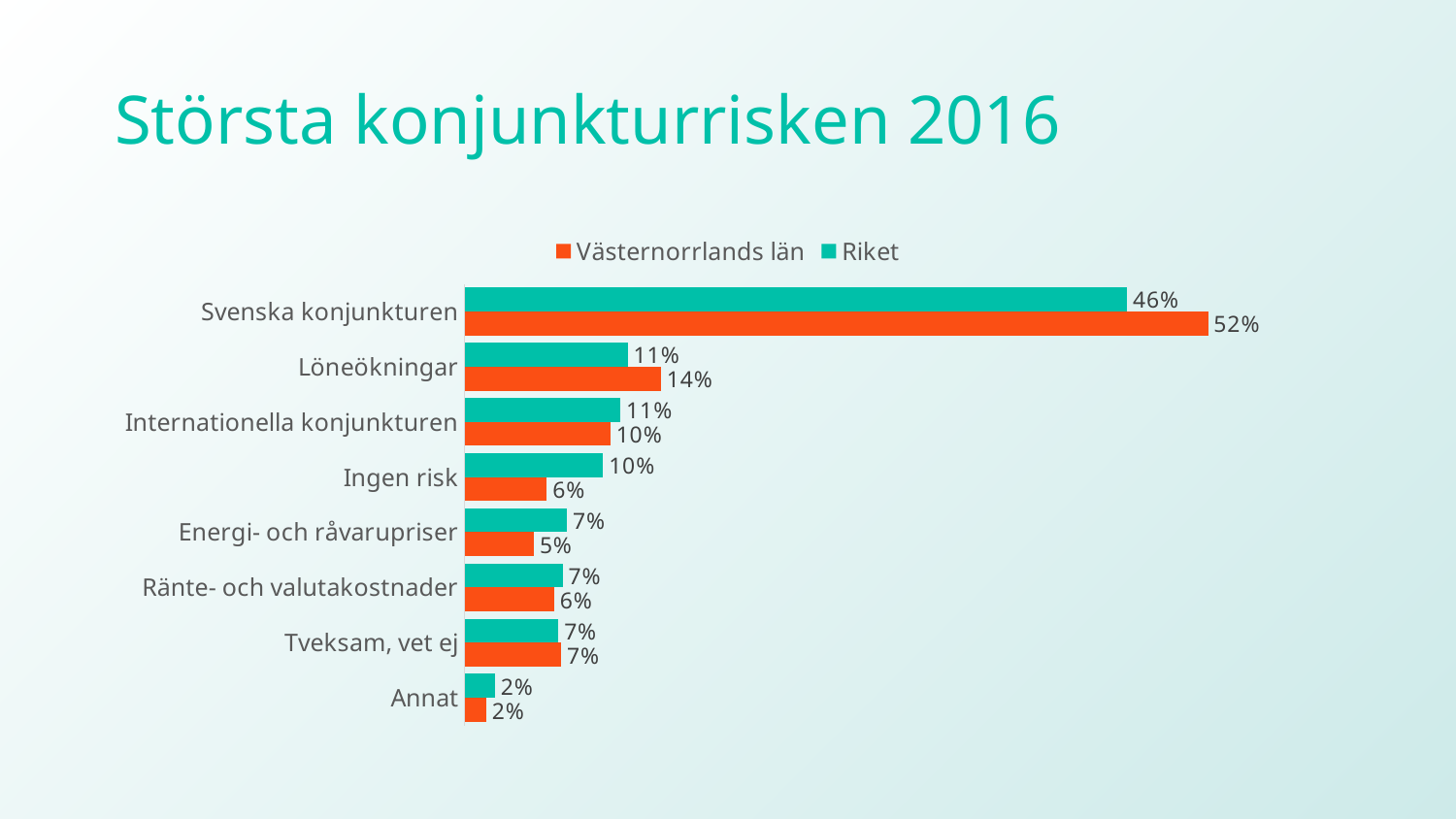
What is the difference between the Riket and Västernorrlands län values for Ingen risk? 4% For Energi- och råvarupriser, which series has the larger value, Västernorrlands län or Riket? Riket What is the value for Ingen risk in the Västernorrlands län series? 6% Which category has the lowest value in the Västernorrlands län series? Annat What is the value for Löneökningar in the Riket series? 11% Which category has the highest value in the Riket series? Svenska konjunkturen What is the value for Svenska konjunkturen in the Västernorrlands län series? 52% How many categories are shown in the chart? 8 How many series does the legend list? 2 For Löneökningar, which series has the larger value, Västernorrlands län or Riket? Västernorrlands län What is the difference between the Västernorrlands län and Riket values for Svenska konjunkturen? 6% What kind of chart is shown on the slide? Bar chart